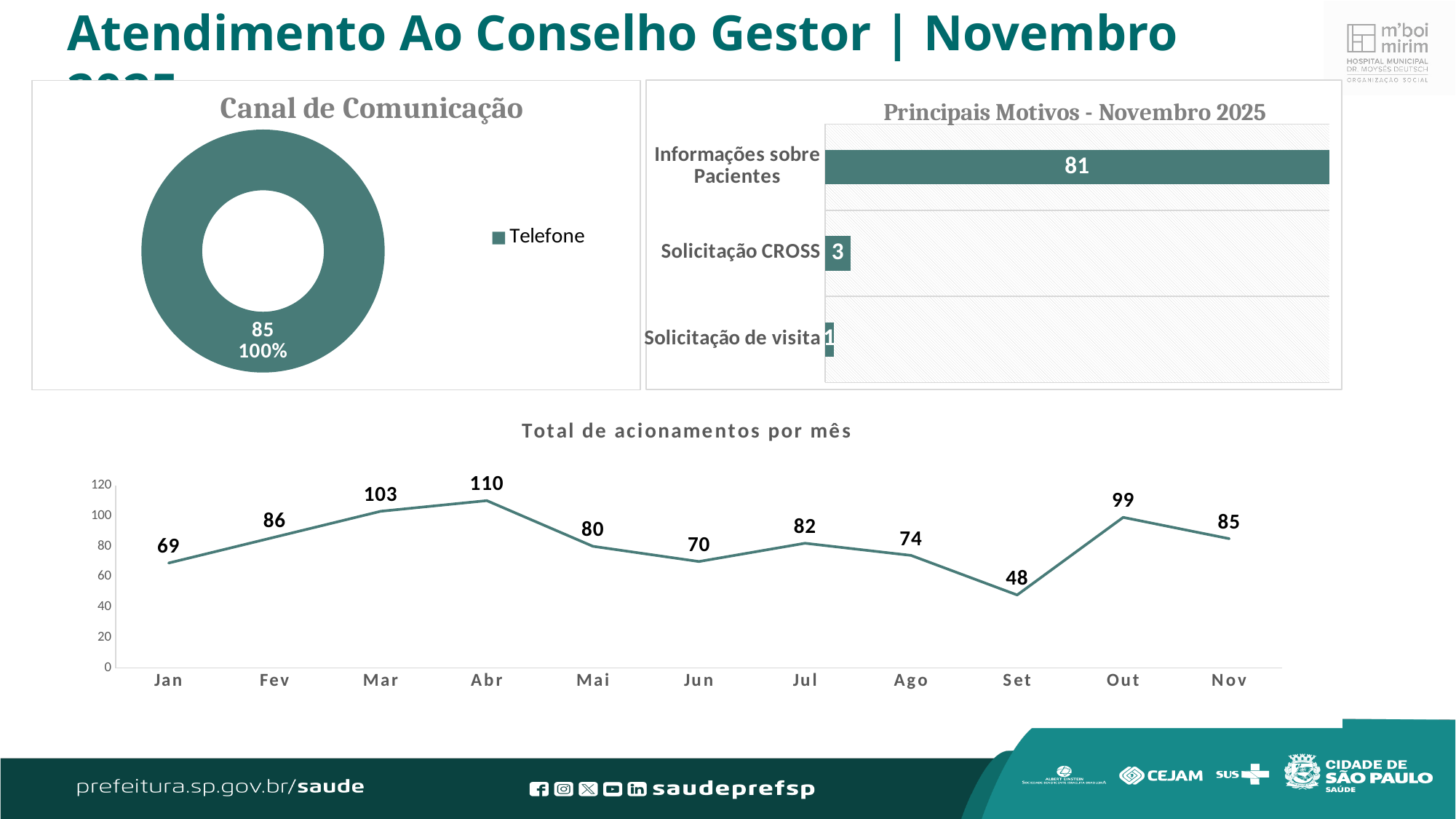
In the 'Total de acionamentos por mês' chart, what is the difference between Out and Set? 51 In the 'Principais Motivos - Novembro 2025' chart, which category has the lowest value? Solicitação de visita What kind of chart is 'Principais Motivos - Novembro 2025'? bar chart In the 'Principais Motivos - Novembro 2025' chart, what is the value for Informações sobre Pacientes? 81 In the 'Principais Motivos - Novembro 2025' chart, what is the difference between Informações sobre Pacientes and Solicitação CROSS? 78 In the 'Total de acionamentos por mês' chart, which month has the highest value? Abr In the 'Total de acionamentos por mês' chart, which month has the lowest value? Set In the 'Total de acionamentos por mês' chart, which is larger, Mar or Jul? Mar How many months are plotted in the 'Total de acionamentos por mês' chart? 11 In the 'Total de acionamentos por mês' chart, what is the value for Abr? 110 In the 'Canal de Comunicação' chart, what value is shown for Telefone? 85 In the 'Canal de Comunicação' chart, what share does Telefone have? 100%